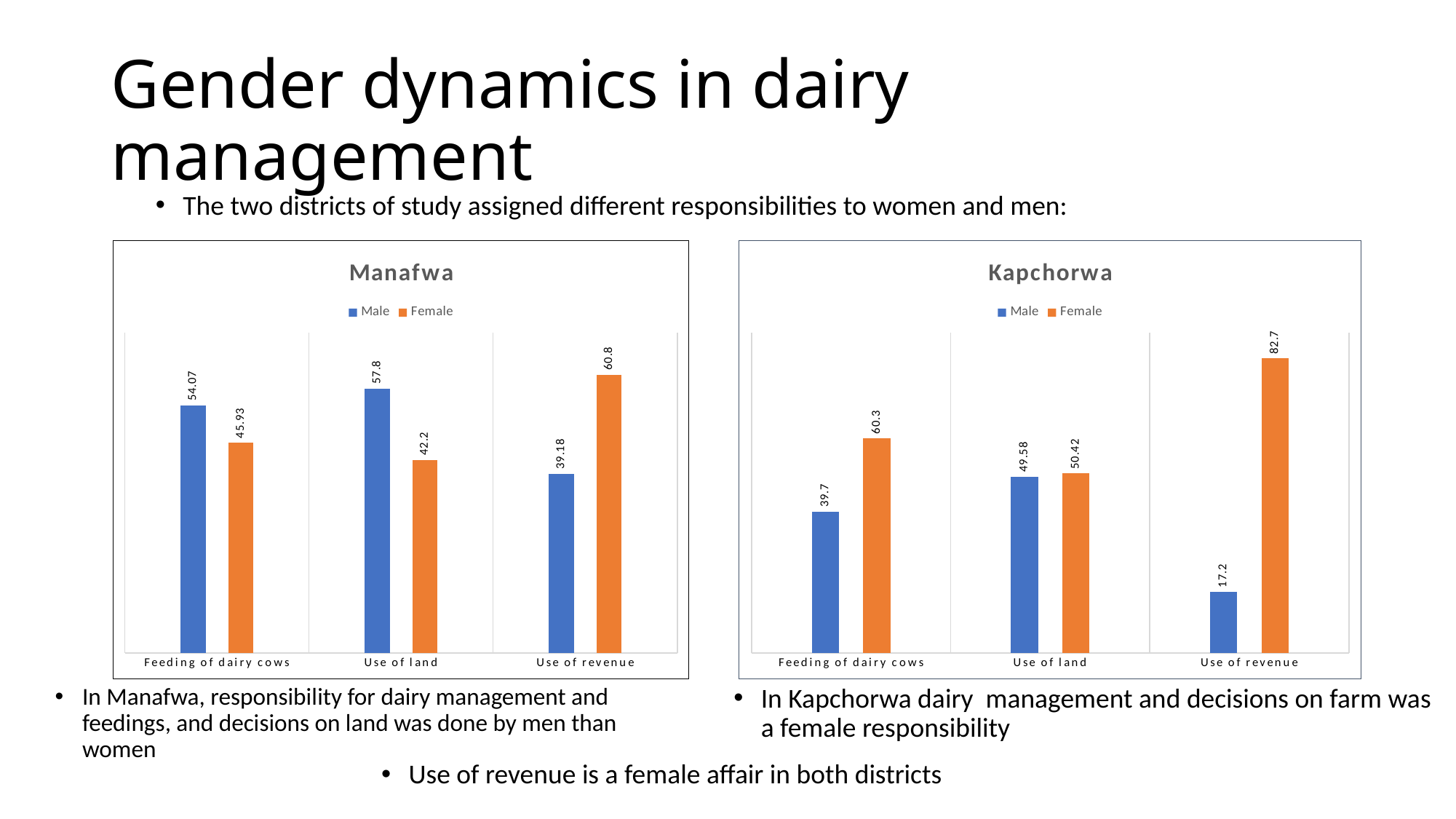
What kind of chart is the Kapchorwa chart? Bar chart In the Kapchorwa chart, what is the difference between the Female and Male values for Use of revenue? 65.5 In the Manafwa chart, what is the Male value for Use of land? 57.8 How many series does the legend of the Manafwa chart list? 2 In the Manafwa chart, which category has the lowest Male value? Use of revenue In the Kapchorwa chart, what is the Male value for Use of revenue? 17.2 In the Manafwa chart, which is larger for Use of land, the Male or the Female value? Male In the Manafwa chart, what is the difference between the Male and Female values for Feeding of dairy cows? 8.14 In the Manafwa chart, what is the Female value for Use of revenue? 60.8 In the Kapchorwa chart, what is the Female value for Feeding of dairy cows? 60.3 How many categories are shown on the x axis of the Kapchorwa chart? 3 In the Kapchorwa chart, which category has the highest Female value? Use of revenue